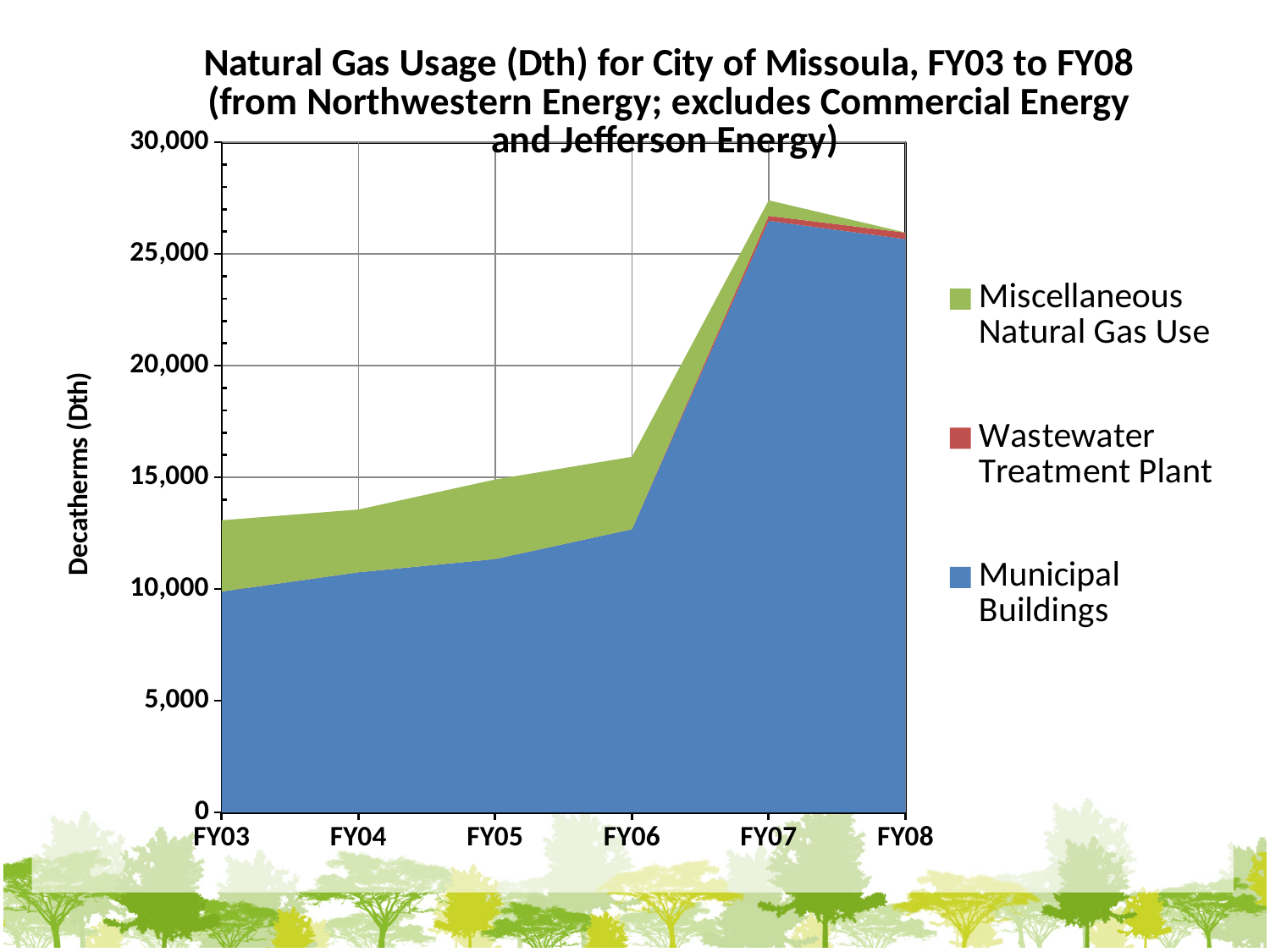
Which fiscal year has the lowest total natural gas usage? FY03 Is the Municipal Buildings value for FY06 greater or less than 15,000? less How many series does the legend list? 3 Which colour represents the Wastewater Treatment Plant series? Red What kind of chart is shown on the slide? Stacked area chart How many fiscal years are plotted along the x axis? 6 Which fiscal year has the highest total natural gas usage? FY07 Is the total natural gas usage for FY03 greater or less than 15,000? less Is the Municipal Buildings value for FY08 greater or less than 20,000? greater Does the total natural gas usage rise or fall from FY03 to FY07? rise What is the label on the vertical axis? Decatherms (Dth)